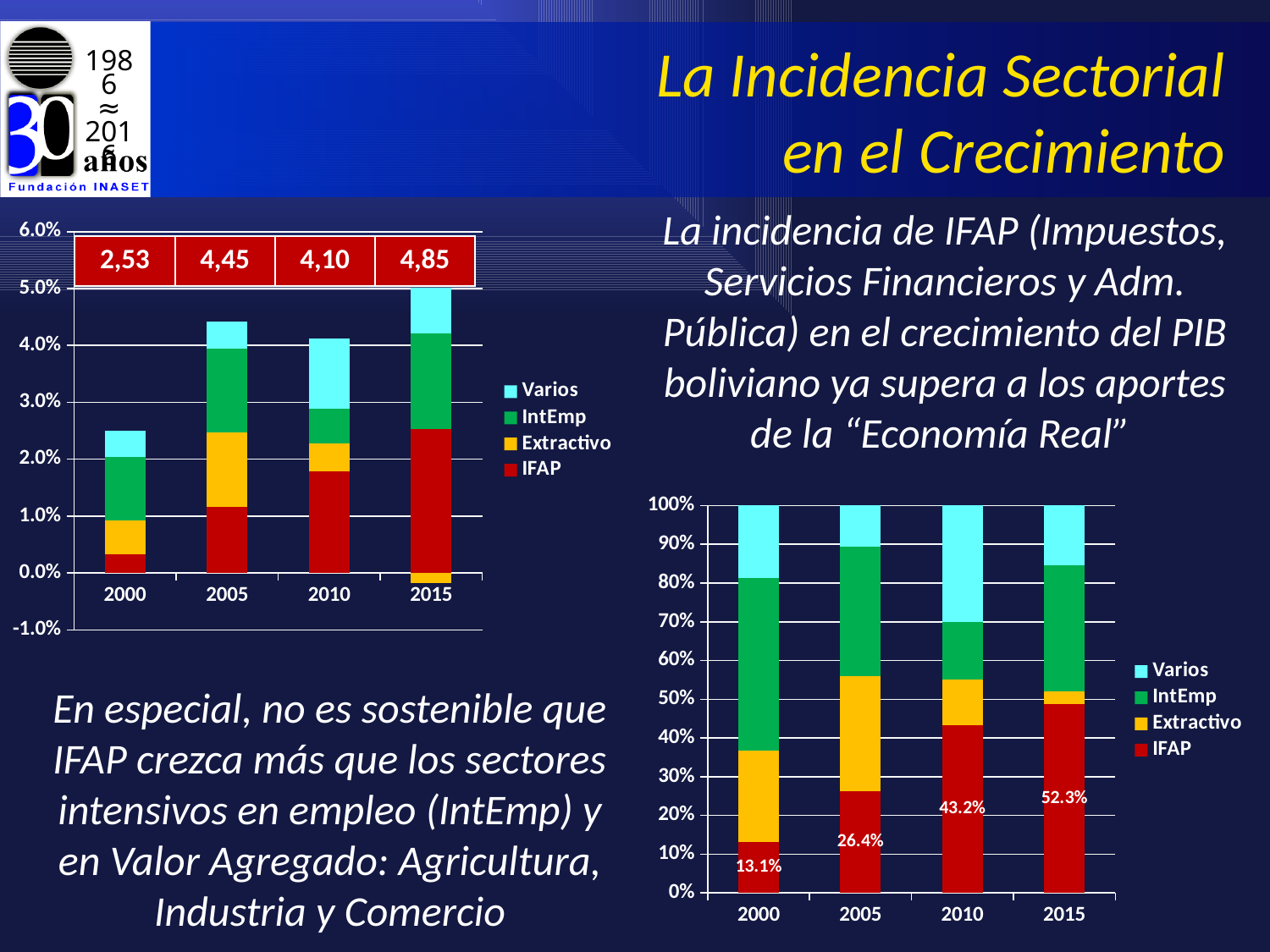
On the left chart, what is the difference between the printed values for 2015 and 2000? 2,32 On the left chart, which year has the lowest value printed in the red box? 2000 On the right chart, what is the IFAP share for 2000? 13.1% On the left chart, which year has the highest value printed in the red box? 2015 On the right chart, in which year is the IFAP share highest? 2015 On the left chart, which year has the larger printed value, 2005 or 2010? 2005 On the left chart, is the IFAP segment for 2015 greater or less than 2.0%? greater On the right chart, what is the IFAP share for 2010? 43.2% On the right chart, does the IFAP share rise or fall from 2000 to 2015? rise On the right chart, what is the difference between the IFAP share in 2015 and in 2000? 39.2% How many series does the legend of the right chart list? 4 On the left chart, what value is printed in the red box above the 2005 bar? 4,45